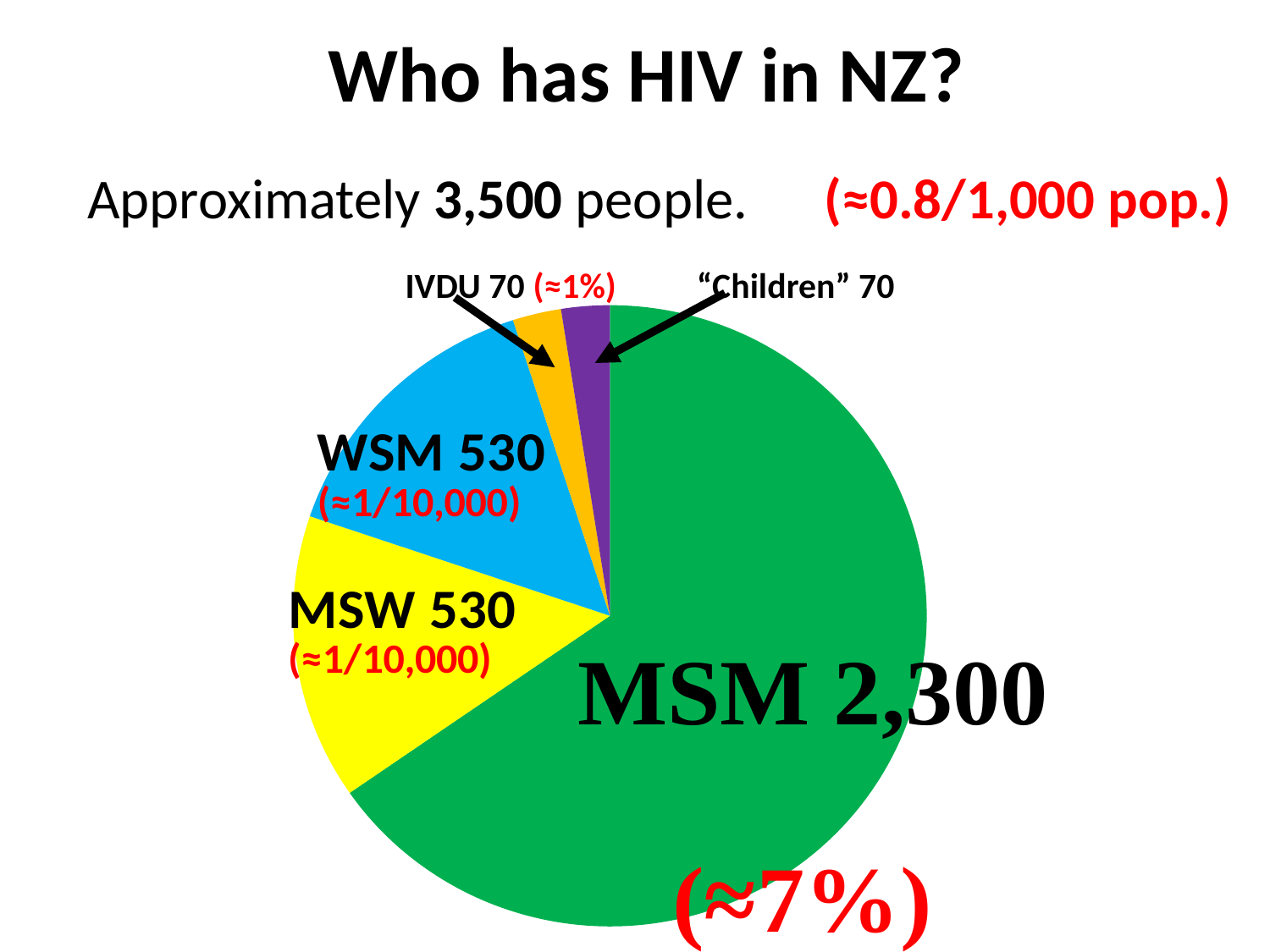
How many people are in the MSM slice of the pie chart? 2,300 What is the difference between the WSM value and the IVDU value? 460 What kind of chart is shown on the slide? Pie chart What value is shown for the IVDU slice? 70 What value is shown for the "Children" slice? 70 Which is larger, the MSM slice or the WSM slice? MSM Which category has the largest slice of the pie chart? MSM What is the difference between the MSM value and the MSW value? 1,770 What is the title of the chart on the slide? Who has HIV in NZ? How many categories (slices) does the pie chart have? 5 What colour is the MSM slice of the pie chart? Green What value is shown for the WSM slice? 530